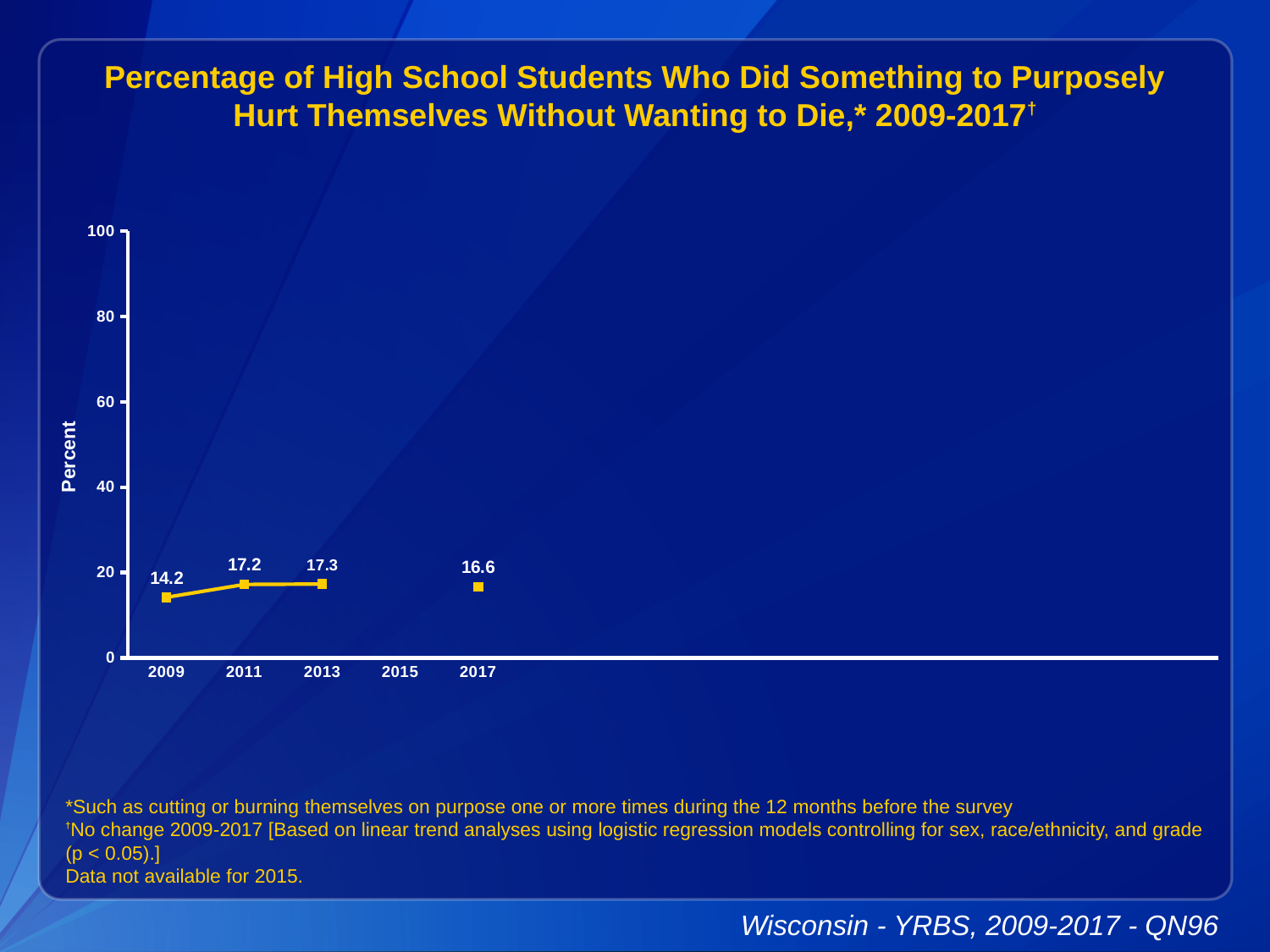
What is the value for 2009? 14.2 Which is larger, the value for 2009 or the value for 2017? 2017 Is the value for 2013 greater or less than 20? less What is the difference between the values for 2013 and 2017? 0.7 What is the value for 2017? 16.6 What kind of chart is this? line chart What is the value for 2013? 17.3 What is the label of the y axis? Percent What is the difference between the values for 2011 and 2009? 3.0 How many years are labeled on the x axis? 5 Which year has the lowest value? 2009 What is the value for 2011? 17.2